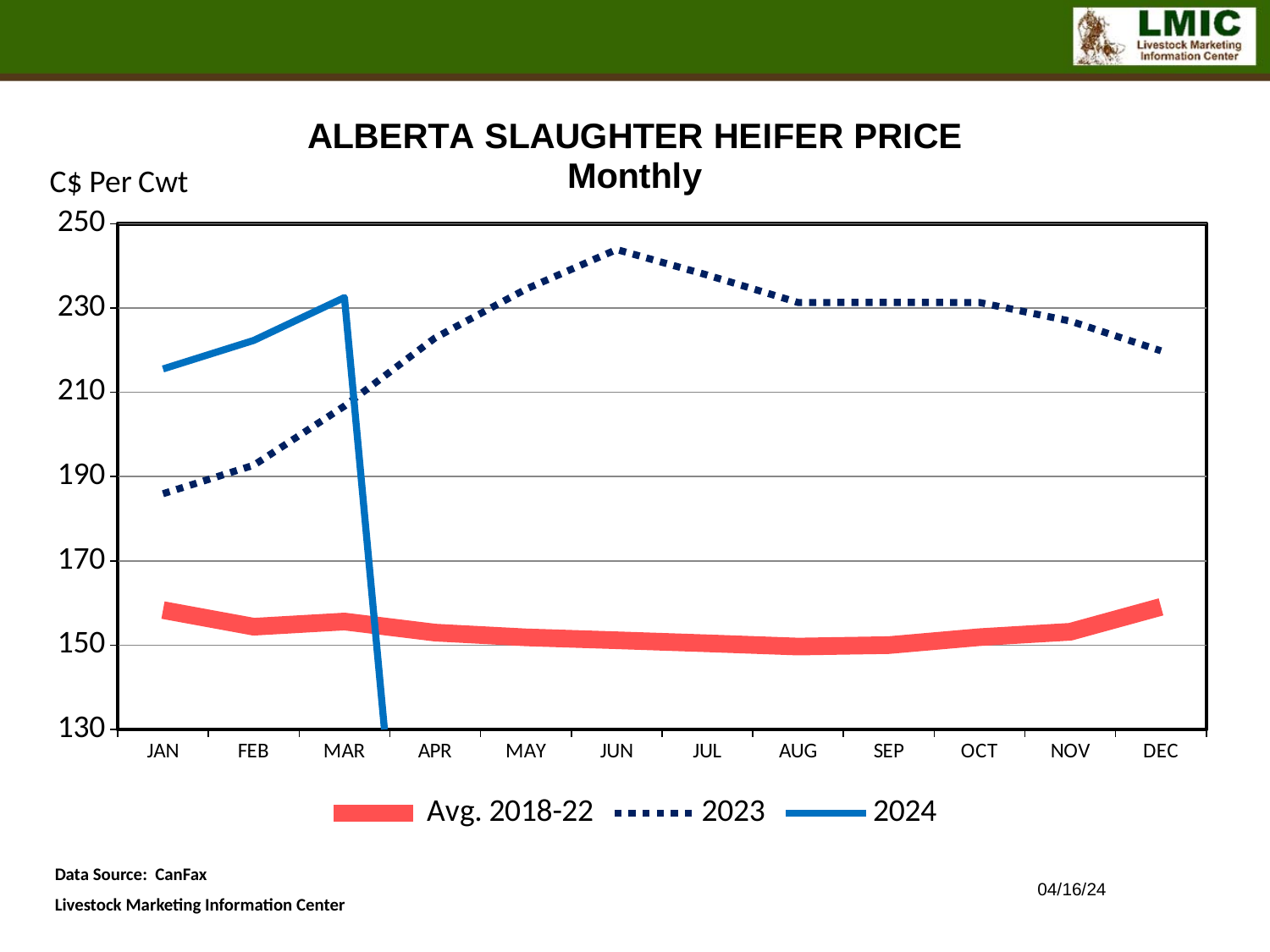
Is the 2023 value for JUN greater or less than 230? greater How many series does the legend list? 3 Does the 2024 series rise or fall from JAN to MAR? rise Is the Avg. 2018-22 value for JAN greater or less than 150? greater Is the 2023 value for JAN greater or less than 190? less What kind of chart is shown on the slide? line chart Which series has the larger value in JUN, 2023 or Avg. 2018-22? 2023 What unit is shown on the y axis label? C$ Per Cwt In which month is the 2023 series at its lowest value? JAN In which month does the 2023 series reach its highest value? JUN How many months are shown along the x axis? 12